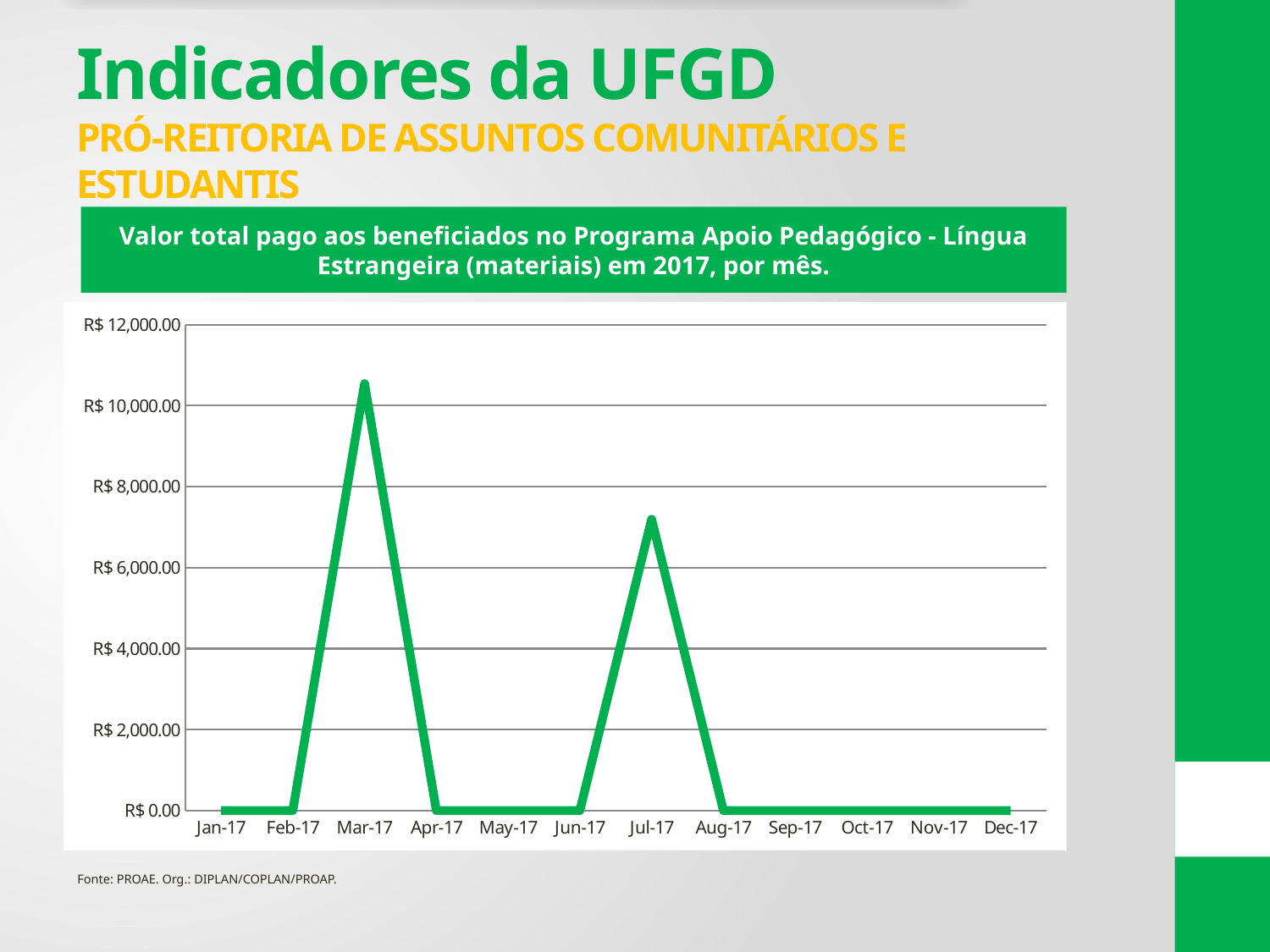
Is the value for Jul-17 greater or less than R$ 6,000.00? greater Does the value rise or fall from Mar-17 to Apr-17? fall Is the value for Mar-17 greater or less than R$ 10,000.00? greater What kind of chart is shown on the slide? line chart What is the value plotted for Dec-17? R$ 0.00 Is the value for Jul-17 greater or less than R$ 8,000.00? less How many months are plotted along the x axis of the chart? 12 What is the value plotted for Jan-17? R$ 0.00 Does the value rise or fall from Jun-17 to Jul-17? rise What is the title of the chart? Valor total pago aos beneficiados no Programa Apoio Pedagógico - Língua Estrangeira (materiais) em 2017, por mês. Which month has the highest value in the chart? Mar-17 Which is larger, the value for Mar-17 or the value for Jul-17? Mar-17